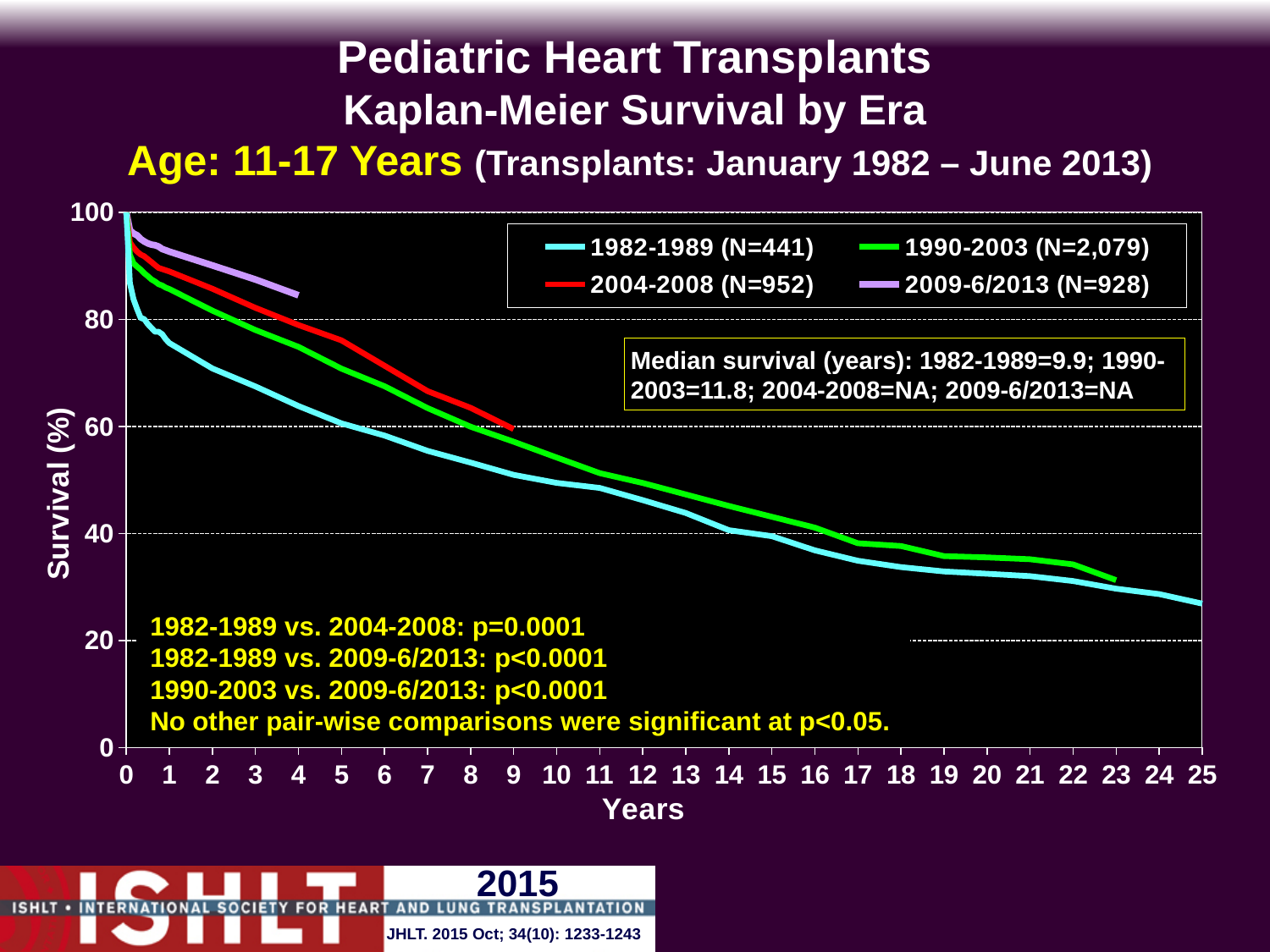
What is the median survival in years for the 1982-1989 era? 9.9 Which era's curve has the highest survival at 2 years? 2009-6/2013 Do the survival curves rise or fall as years increase along the x axis? fall At 5 years, which era has higher survival: 1982-1989 or 2004-2008? 2004-2008 What is the N for the 1982-1989 era shown in the legend? 441 Is the survival value for the 2009-6/2013 era at 4 years greater or less than 80? greater What is the median survival in years for the 1990-2003 era? 11.8 What kind of chart is shown on the slide? line chart How many series does the legend list? 4 What colour is the line for the 2004-2008 era? red What is the N for the 1990-2003 era shown in the legend? 2,079 Is the survival value for the 1982-1989 era at 20 years greater or less than 40? less